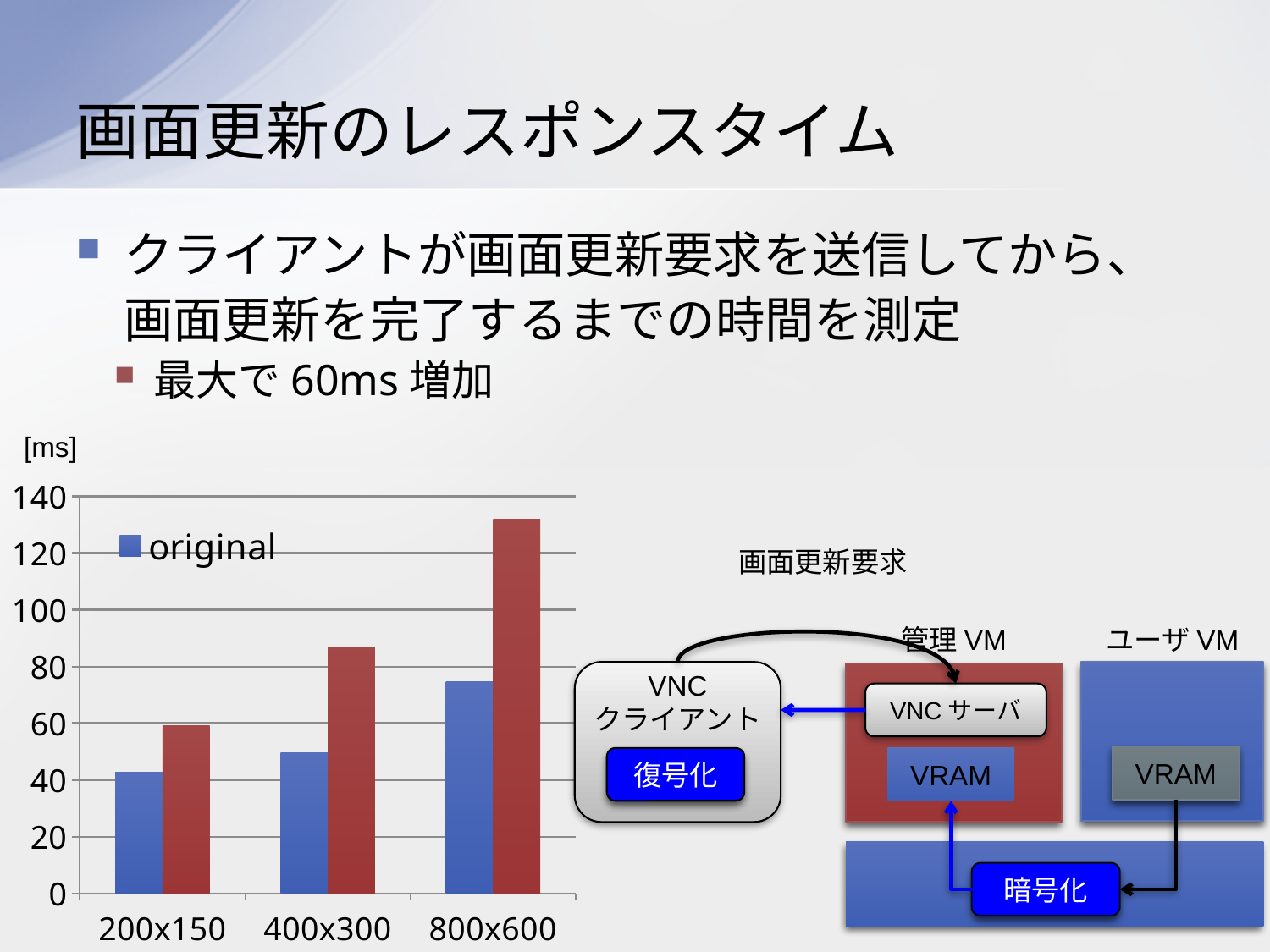
Which series name is shown in the chart legend? original What unit is shown on the y axis of the chart? [ms] Is the original (blue) bar for 200x150 greater or less than 60? less Which category has the highest red bar in the chart? 800x600 For 800x600, which bar is larger, the blue (original) bar or the red bar? the red bar Is the red bar for 400x300 greater or less than 80? greater How many bars are plotted for each category in the chart? 2 Do the original (blue) bar values rise or fall from 200x150 to 800x600? rise Which category has the lowest blue (original) bar in the chart? 200x150 Is the red bar for 800x600 greater or less than 120? greater How many categories are shown on the x axis of the chart? 3 What kind of chart is shown on the slide? bar chart